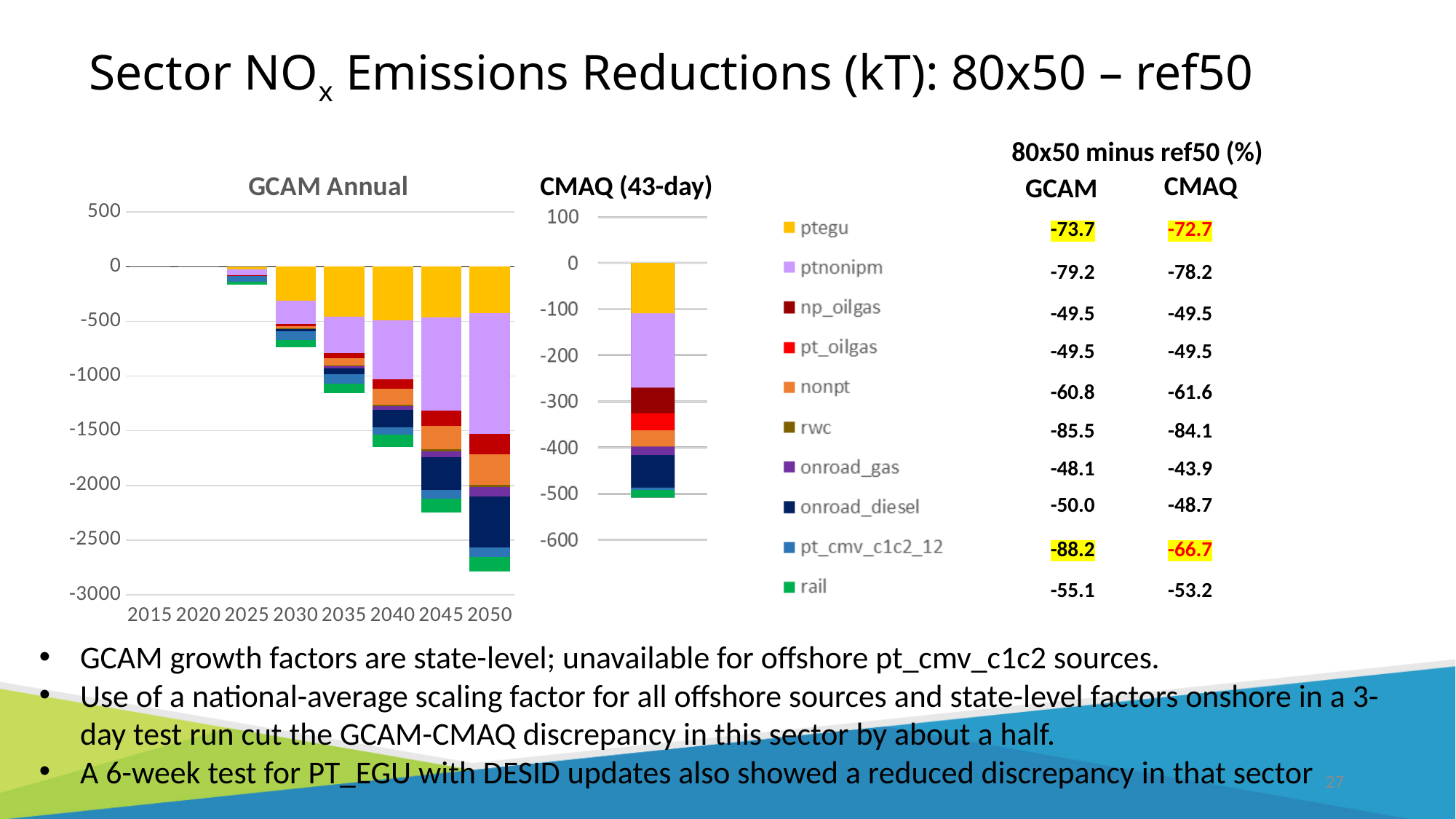
Which series is shown in yellow in the legend? ptegu In the GCAM Annual chart, is the total for 2030 greater or less than -1000? greater How many years have bars plotted in the GCAM Annual chart? 6 In the GCAM Annual chart, is the total for 2050 greater or less than -2500? less In the GCAM Annual chart, which year has the largest total reduction (most negative bar)? 2050 In the GCAM Annual chart, do the stacked totals become more negative or less negative from 2025 to 2050? more negative What type of chart is the GCAM Annual chart? bar chart In the GCAM Annual chart, which series has the largest segment in the 2050 bar? ptnonipm In the CMAQ (43-day) chart, is the total of the bar greater or less than -400? less How many bars are plotted in the CMAQ (43-day) chart? 1 How many series does the legend list? 10